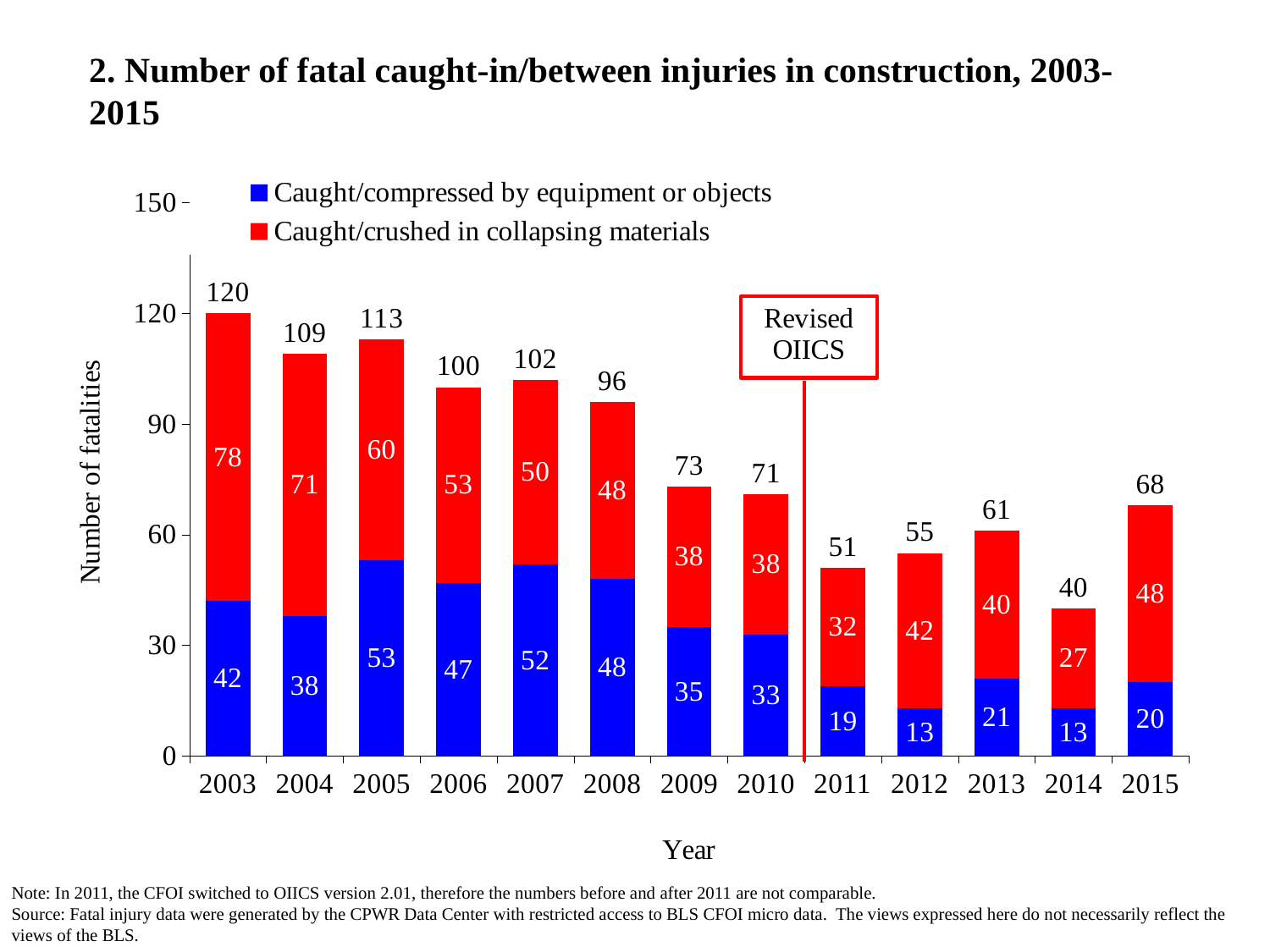
What is the difference between the total fatalities in 2003 and 2015? 52 Which year has the highest total number of fatalities? 2003 Do the total fatalities generally rise or fall from 2003 to 2010? Fall What is the total number of fatal caught-in/between injuries in 2003? 120 What kind of chart is shown on the slide? Stacked bar chart Which year has the lowest total number of fatalities? 2014 How many series does the legend list? 2 How many fatalities from 'Caught/compressed by equipment or objects' were there in 2012? 13 How many years are shown on the x axis? 13 How many fatalities from 'Caught/crushed in collapsing materials' were there in 2005? 60 Which is larger: the 'Caught/compressed by equipment or objects' value in 2005 or in 2009? 2005 Which colour represents 'Caught/crushed in collapsing materials'? Red